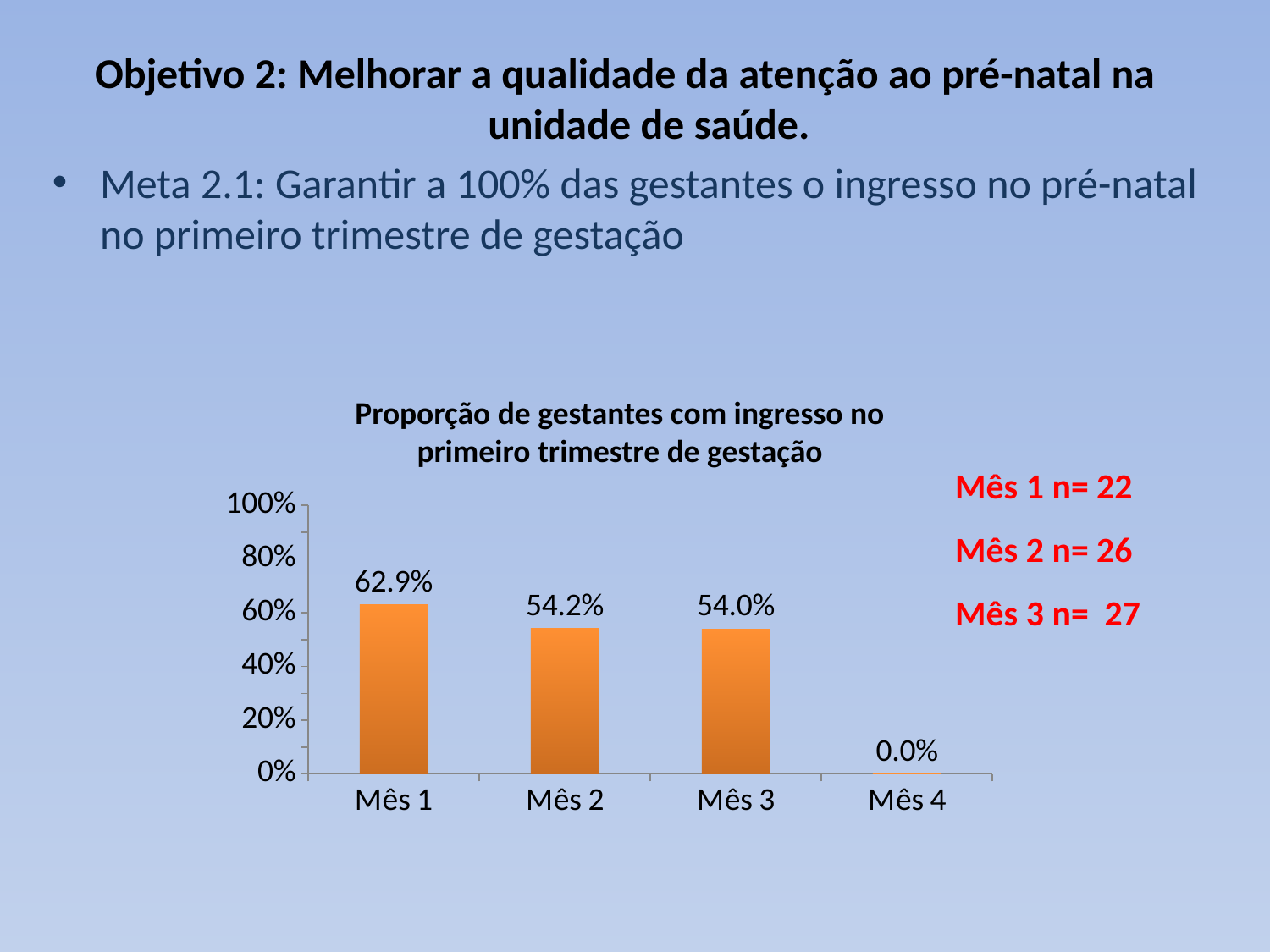
What is the value for Mês 3? 54.0% How many categories are shown on the x axis? 4 Which is larger, the value for Mês 1 or the value for Mês 3? Mês 1 What is the value for Mês 1? 62.9% What is the difference between the values for Mês 1 and Mês 2? 8.7% What kind of chart is shown on the slide? bar chart What is the value for Mês 2? 54.2% What is the title of the chart? Proporção de gestantes com ingresso no primeiro trimestre de gestação Which month has the highest proportion? Mês 1 Is the value for Mês 2 greater or less than 60%? less Which month has the lowest proportion? Mês 4 What is the value for Mês 4? 0.0%